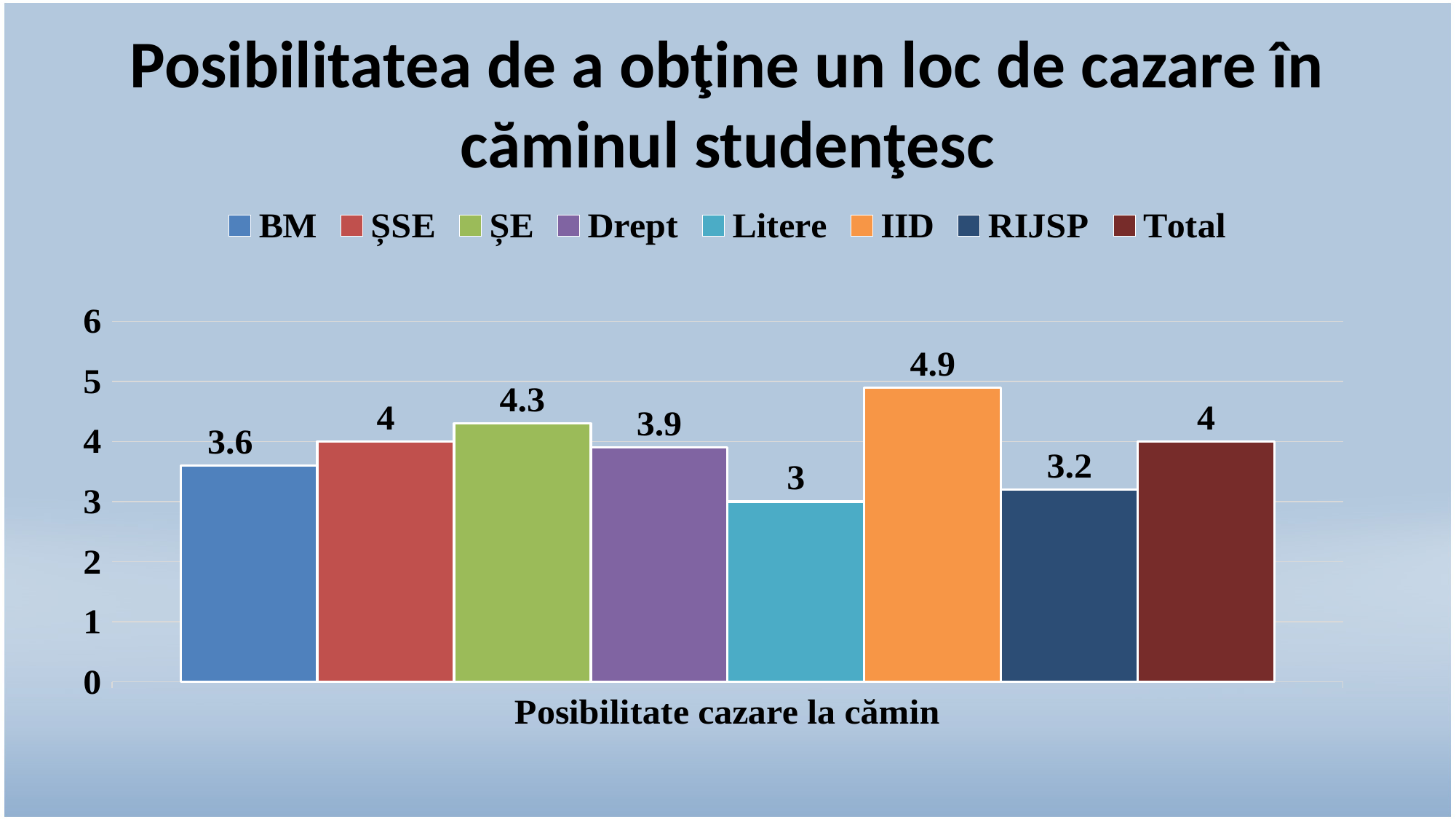
How many series does the legend list? 8 What is the value for Litere? 3 What is the difference between the values for ȘE and BM? 0.7 What is the value for Drept? 3.9 What is the difference between the values for IID and RIJSP? 1.7 Which series has the lowest value? Litere Which series has the highest value? IID Which is larger, the value for ȘSE or the value for RIJSP? ȘSE What is the label on the horizontal axis of the chart? Posibilitate cazare la cămin What kind of chart is shown on the slide? Bar chart What is the value for IID? 4.9 What is the value for BM? 3.6